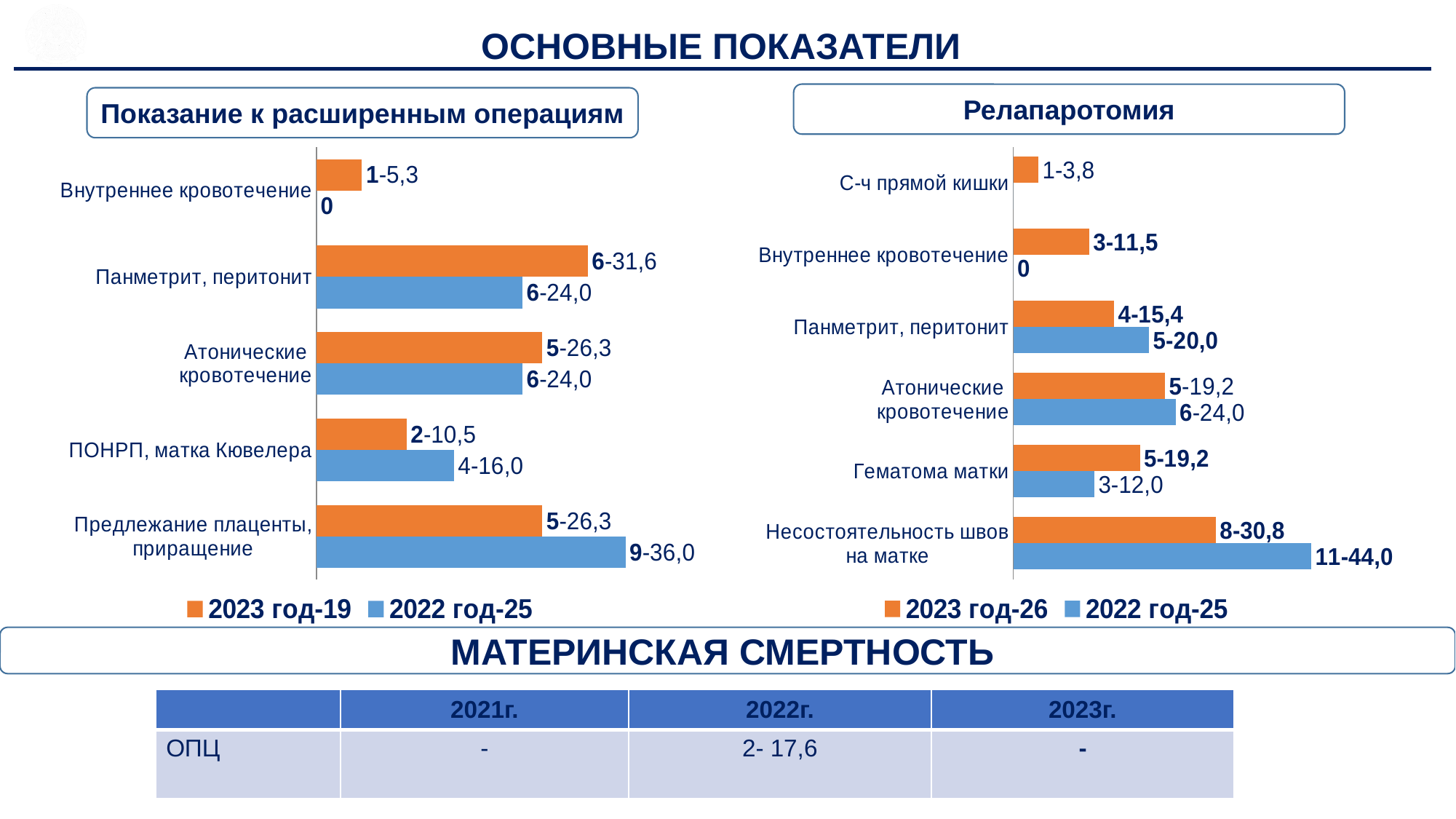
On the 'Показание к расширенным операциям' chart, what is the data label for 'ПОНРП, матка Кювелера' in the 2022 год series? 4-16,0 On the 'Релапаротомия' chart, what is the data label for 'Несостоятельность швов на матке' in the 2022 год series? 11-44,0 On the 'Релапаротомия' chart, what is the data label for 'Гематома матки' in the 2023 год series? 5-19,2 What kind of chart is the 'Релапаротомия' chart? Bar chart On the 'Показание к расширенным операциям' chart, how many series does the legend list? 2 On the 'Показание к расширенным операциям' chart, what is the data label for 'Панметрит, перитонит' in the 2023 год series? 6-31,6 On the 'Показание к расширенным операциям' chart, what is the data label for 'Предлежание плаценты, приращение' in the 2022 год series? 9-36,0 On the 'Релапаротомия' chart, how many categories are shown? 6 On the 'Релапаротомия' chart, what is the data label for 'С-ч прямой кишки' in the 2023 год series? 1-3,8 On the 'Релапаротомия' chart, which category has the longest 2023 год bar? Несостоятельность швов на матке On the 'Показание к расширенным операциям' chart, how many categories are shown? 5 On the 'Показание к расширенным операциям' chart, which category has the longest 2022 год bar? Предлежание плаценты, приращение